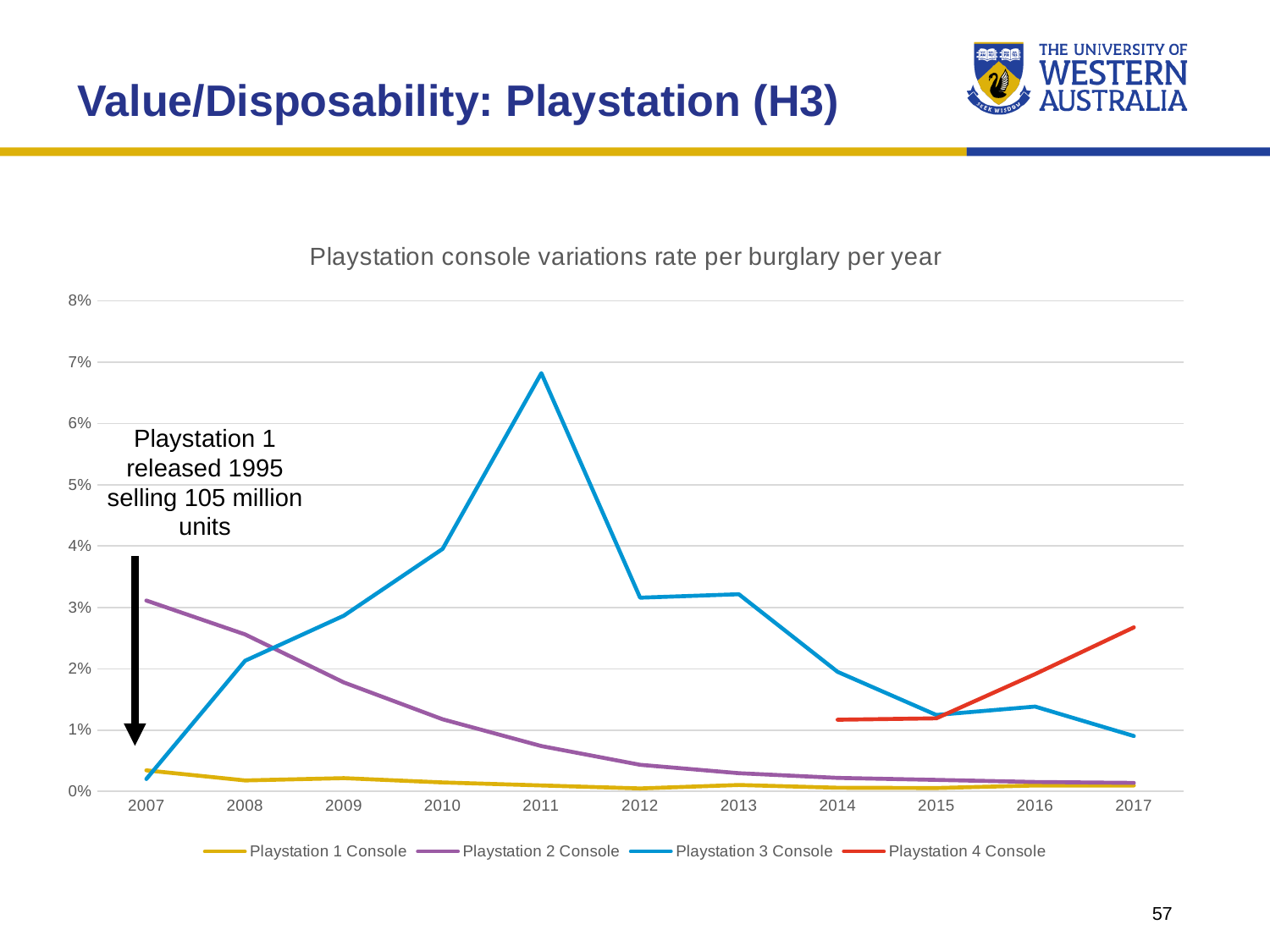
What is the title of the chart? Playstation console variations rate per burglary per year Is the value for Playstation 3 Console in 2013 greater or less than 4%? less In 2007, which is higher: Playstation 2 Console or Playstation 3 Console? Playstation 2 Console Does the Playstation 2 Console line rise or fall from 2007 to 2017? fall What kind of chart is shown on the slide? line chart How many years are shown on the x axis? 11 Is the value for Playstation 2 Console in 2007 greater or less than 2%? greater Is the value for Playstation 3 Console in 2011 greater or less than 6%? greater In 2017, which is higher: Playstation 4 Console or Playstation 3 Console? Playstation 4 Console How many series does the legend list? 4 In which year is the Playstation 3 Console value lowest? 2007 In which year does the Playstation 3 Console line reach its highest value? 2011